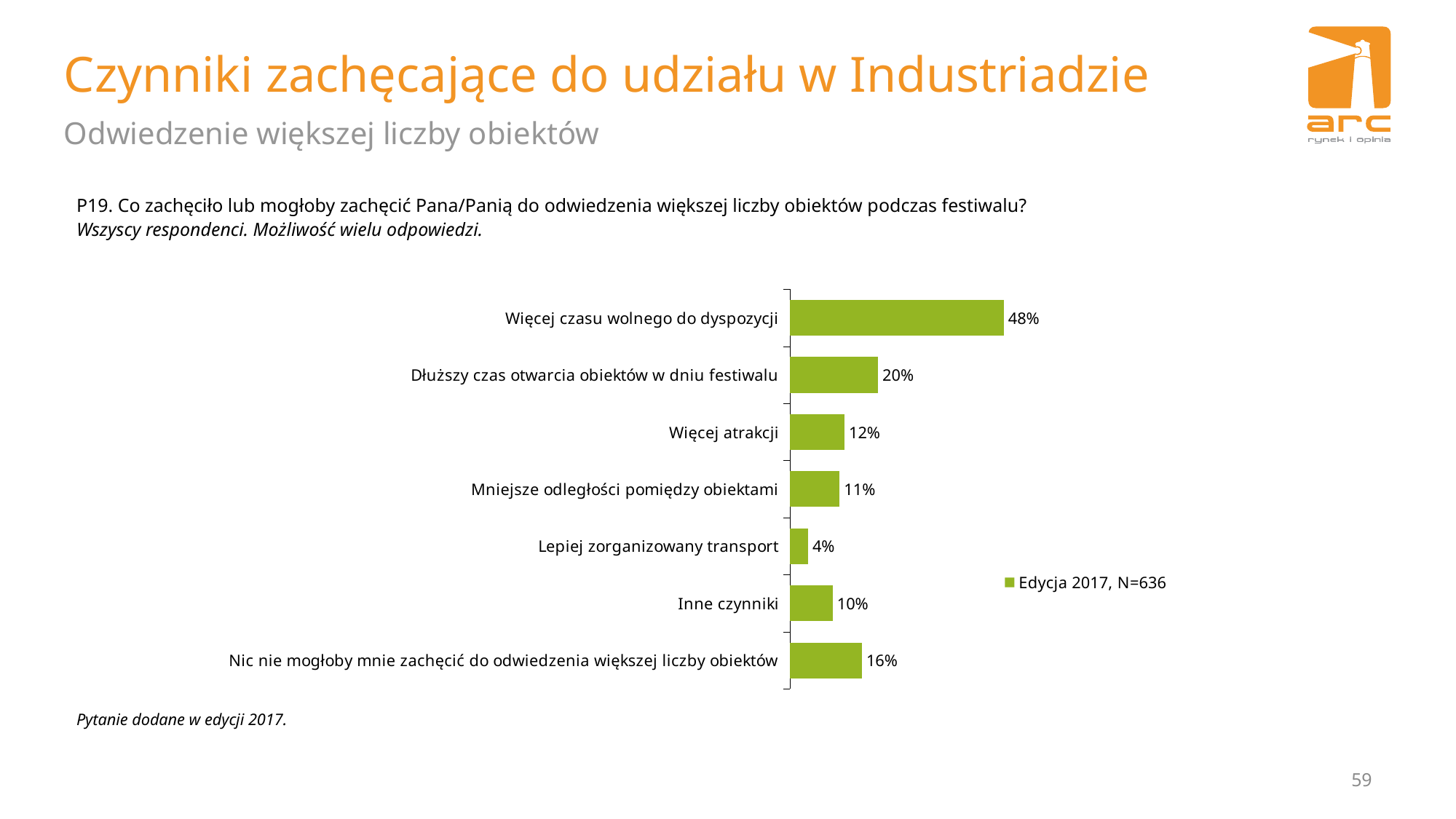
What is the value for "Więcej czasu wolnego do dyspozycji"? 48% Which category has the lowest value? Lepiej zorganizowany transport How many series does the legend list? 1 What is the value for "Nic nie mogłoby mnie zachęcić do odwiedzenia większej liczby obiektów"? 16% What is the value for "Lepiej zorganizowany transport"? 4% What is the difference between the values for "Więcej czasu wolnego do dyspozycji" and "Dłuższy czas otwarcia obiektów w dniu festiwalu"? 28% What kind of chart is shown on the slide? Bar chart What is the value for "Dłuższy czas otwarcia obiektów w dniu festiwalu"? 20% Which category has the highest value? Więcej czasu wolnego do dyspozycji How many categories are shown in the chart? 7 Which is larger: the value for "Więcej atrakcji" or the value for "Inne czynniki"? Więcej atrakcji What is the legend entry of the chart? Edycja 2017, N=636